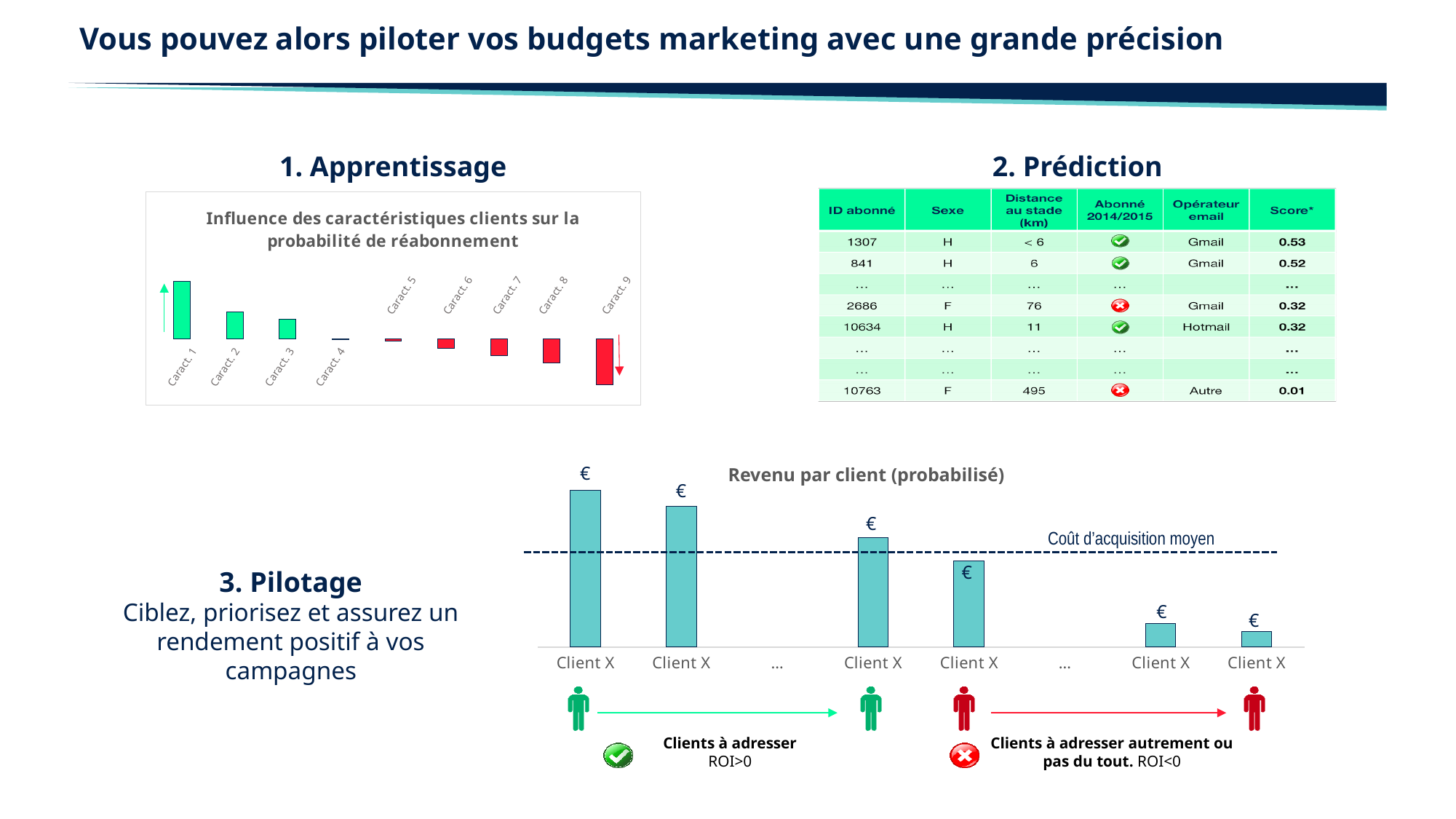
In the chart titled "Influence des caractéristiques clients sur la probabilité de réabonnement", which is larger, the value for Caract. 2 or the value for Caract. 8? Caract. 2 How many bars are plotted in the chart titled "Revenu par client (probabilisé)"? 6 In the chart titled "Influence des caractéristiques clients sur la probabilité de réabonnement", what colour are the bars with negative values? red In the chart titled "Revenu par client (probabilisé)", do the bar heights rise or fall from left to right? fall In the chart titled "Influence des caractéristiques clients sur la probabilité de réabonnement", which category has the lowest value? Caract. 9 What kind of chart is the chart titled "Revenu par client (probabilisé)"? bar chart In the chart titled "Revenu par client (probabilisé)", what does the horizontal dashed line represent? Coût d'acquisition moyen What kind of chart is the chart titled "Influence des caractéristiques clients sur la probabilité de réabonnement"? bar chart In the chart titled "Influence des caractéristiques clients sur la probabilité de réabonnement", which category has the highest value? Caract. 1 In the chart titled "Revenu par client (probabilisé)", which bar is the tallest? the leftmost bar In the chart titled "Influence des caractéristiques clients sur la probabilité de réabonnement", do the values rise or fall from Caract. 1 to Caract. 9? fall How many categories are plotted in the chart titled "Influence des caractéristiques clients sur la probabilité de réabonnement"? 9